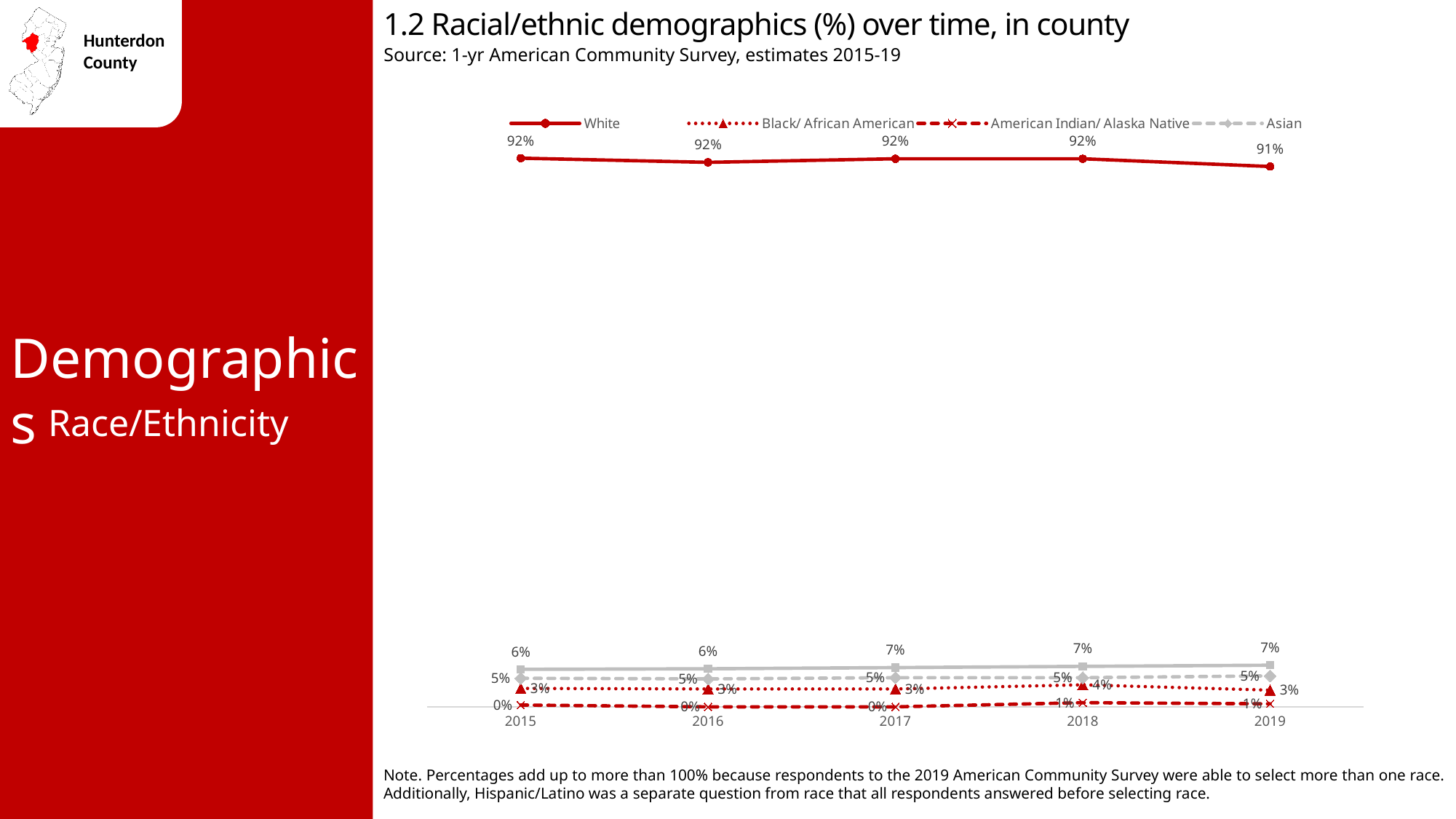
What kind of chart is shown on the slide? line chart What is the value for American Indian/ Alaska Native in 2015? 0% Which is larger in 2019, the value for White or the value for Asian? White What is the difference between the White value in 2015 and in 2019? 1% What is the value for Asian in 2017? 5% In which year is the value for White lowest? 2019 Does the value for American Indian/ Alaska Native rise or fall from 2015 to 2019? rise What is the source cited under the chart title? 1-yr American Community Survey, estimates 2015-19 What is the value for White in 2019? 91% What is the value for White in 2015? 92% How many years are shown on the x axis? 5 What is the value for Black/ African American in 2018? 4%